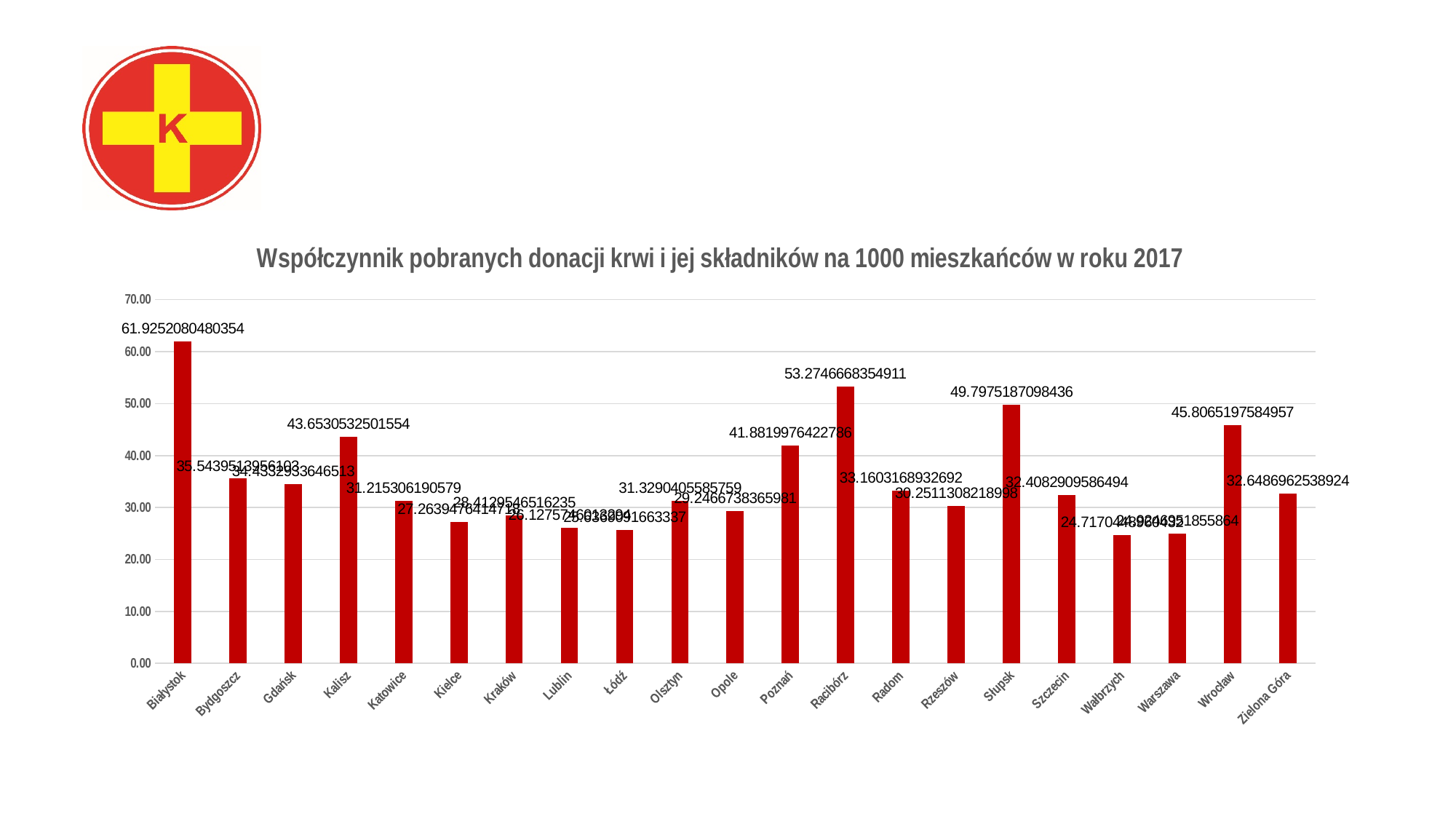
What is the title of the chart? Współczynnik pobranych donacji krwi i jej składników na 1000 mieszkańców w roku 2017 What is the value for Słupsk? 49.7975187098436 Which has a larger value, Kalisz or Wrocław? Wrocław How many cities are shown on the x axis? 21 What is the difference between the values for Białystok and Racibórz? 8.6505412125443 What is the value for Białystok? 61.9252080480354 Is the value for Kielce greater or less than 30? less Which city has the highest value? Białystok What is the value for Wrocław? 45.8065197584957 What is the value for Racibórz? 53.2746668354911 What kind of chart is this? bar chart What is the value for Zielona Góra? 32.6486962538924